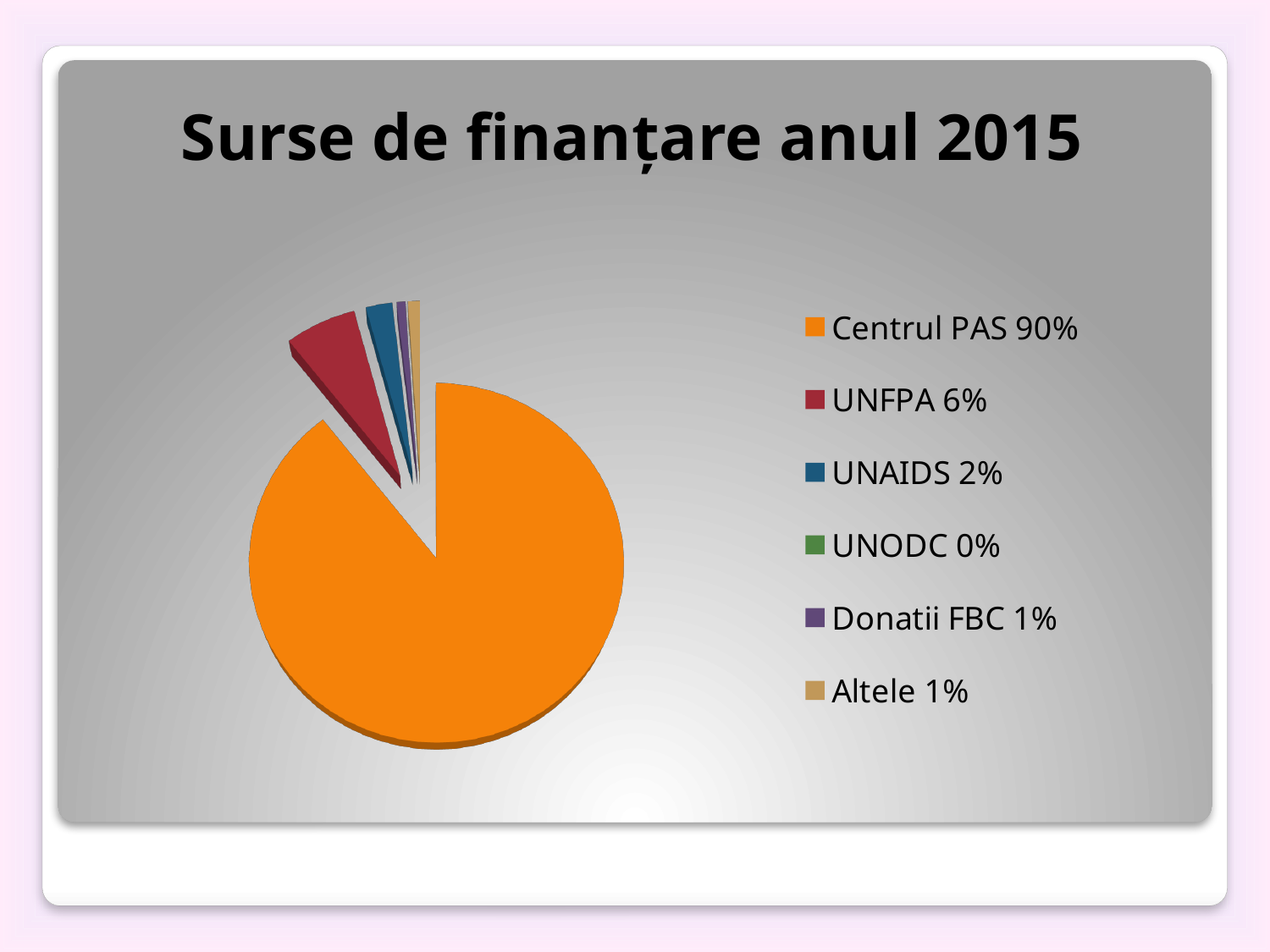
How many categories does the legend list? 6 What share of the pie does UNFPA hold? 6% What share of the pie does UNAIDS hold? 2% What is the title of the chart? Surse de finanțare anul 2015 What share of the pie does Centrul PAS hold? 90% What is the difference in percentage points between the shares of Centrul PAS and UNFPA? 84 What kind of chart is shown on the slide? pie chart Which funding source has the smallest share of the pie? UNODC Which funding source has the largest share of the pie? Centrul PAS Which has a larger share, UNFPA or UNAIDS? UNFPA